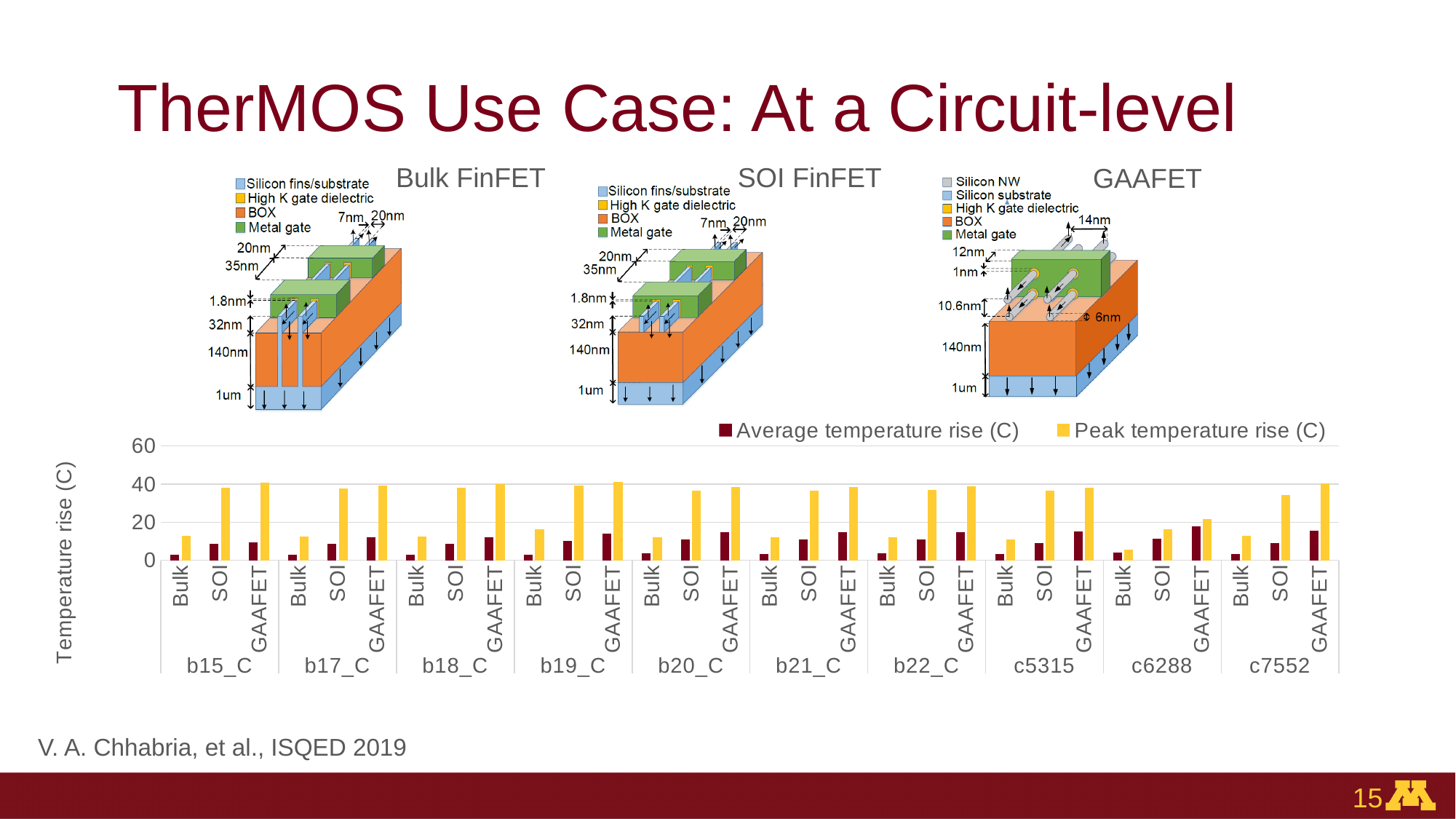
What are the two series named in the chart legend? Average temperature rise (C) and Peak temperature rise (C) What kind of chart is shown on the slide? bar chart In c6288, which technology has the lowest peak temperature rise? Bulk What is the label on the vertical axis of the chart? Temperature rise (C) How many series does the chart legend list? 2 In b15_C, which technology has the highest peak temperature rise? GAAFET Is the peak temperature rise for SOI in b15_C greater or less than 20? greater Is the peak temperature rise for GAAFET in c7552 greater or less than 20? greater Is the peak temperature rise for Bulk in b15_C greater or less than 20? less How many circuit benchmarks (groups such as b15_C, c5315) are shown along the x axis of the chart? 10 For Bulk in b17_C, which is larger: the average temperature rise or the peak temperature rise? Peak temperature rise